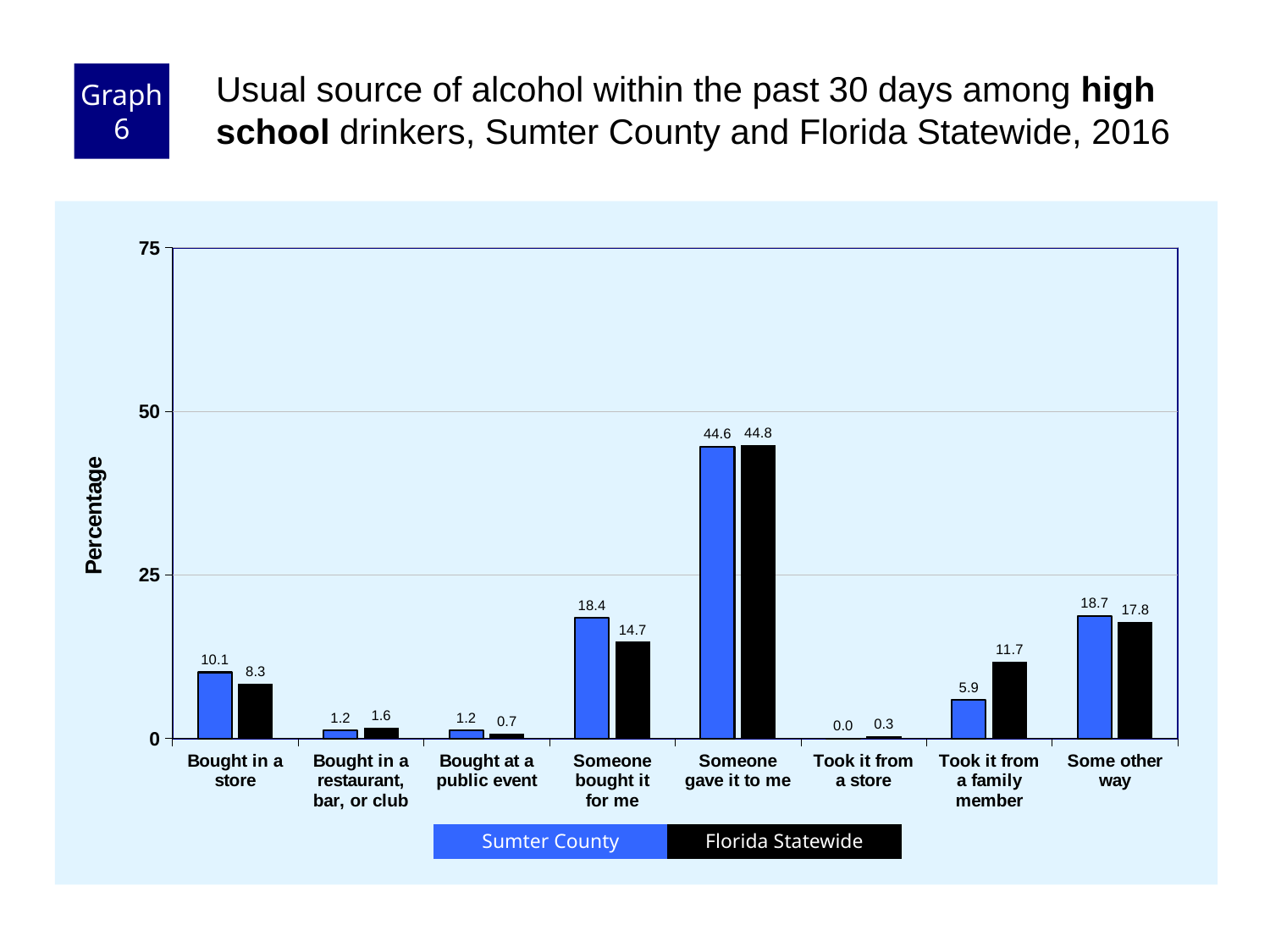
Which category has the lowest Sumter County value? Took it from a store What is the Florida Statewide value for "Took it from a family member"? 11.7 What is the Sumter County value for "Bought in a store"? 10.1 What is the label on the y axis? Percentage Which is larger for "Took it from a family member": Sumter County or Florida Statewide? Florida Statewide What is the Sumter County value for "Someone gave it to me"? 44.6 How many series does the legend list? 2 Is the Sumter County value for "Some other way" greater or less than 25? less Which category has the highest Florida Statewide value? Someone gave it to me What kind of chart is shown on the slide? bar chart How many categories are shown on the x axis? 8 What is the difference between the Sumter County and Florida Statewide values for "Someone bought it for me"? 3.7